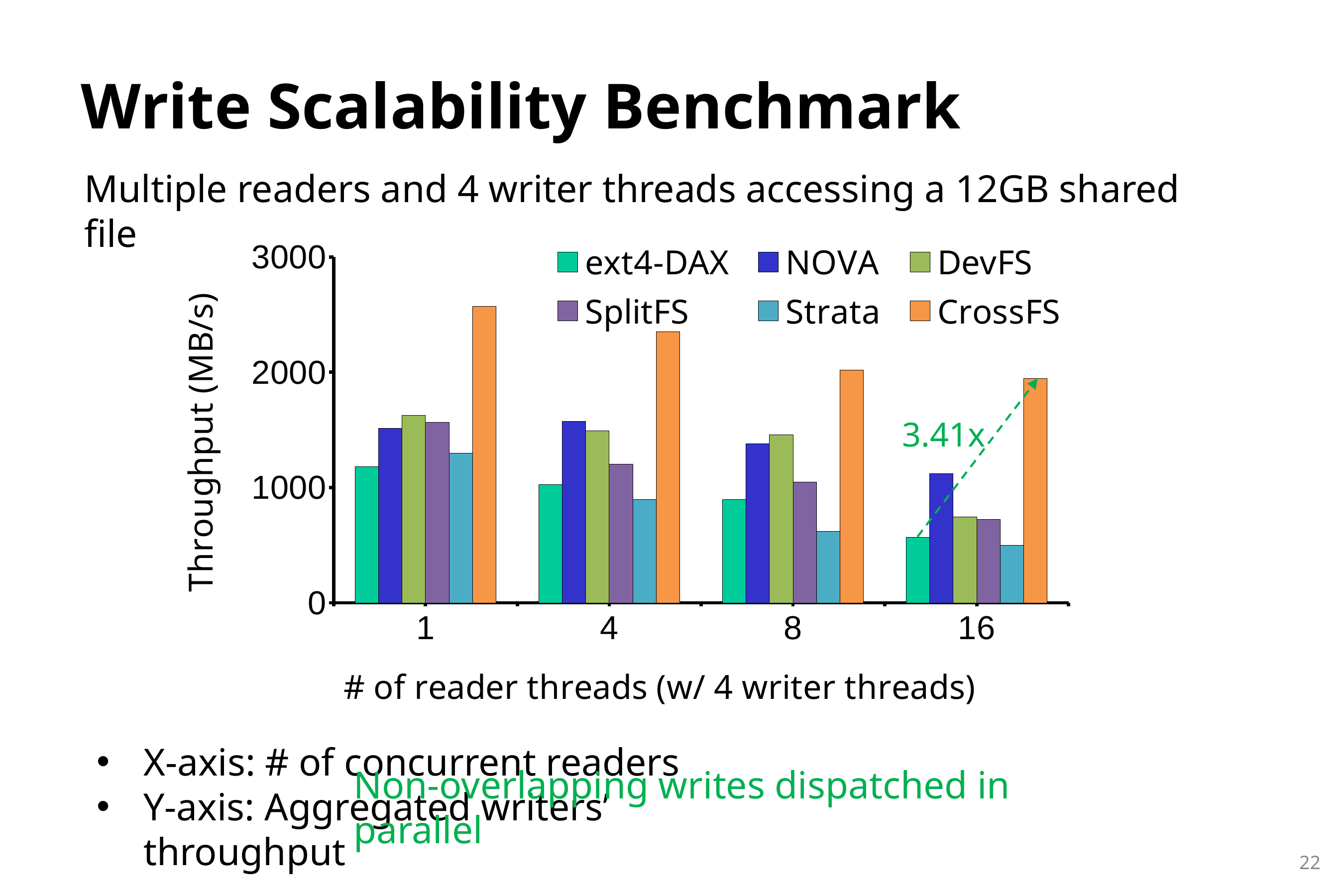
With 16 reader threads, which has higher throughput, NOVA or ext4-DAX? NOVA What is the y-axis label of the chart? Throughput (MB/s) What kind of chart is shown on the slide? bar chart Does the ext4-DAX throughput rise or fall as the number of reader threads increases? fall What speedup factor is annotated next to the 16-reader-thread group? 3.41x Is the Strata throughput with 16 reader threads greater or less than 1000? less Which file system has the highest throughput with 1 reader thread? CrossFS How many reader-thread categories are shown on the x axis? 4 Is the CrossFS throughput with 1 reader thread greater or less than 2000? greater Is the CrossFS throughput with 4 reader threads greater or less than 2000? greater Which file system has the lowest throughput with 8 reader threads? Strata How many series does the legend list? 6